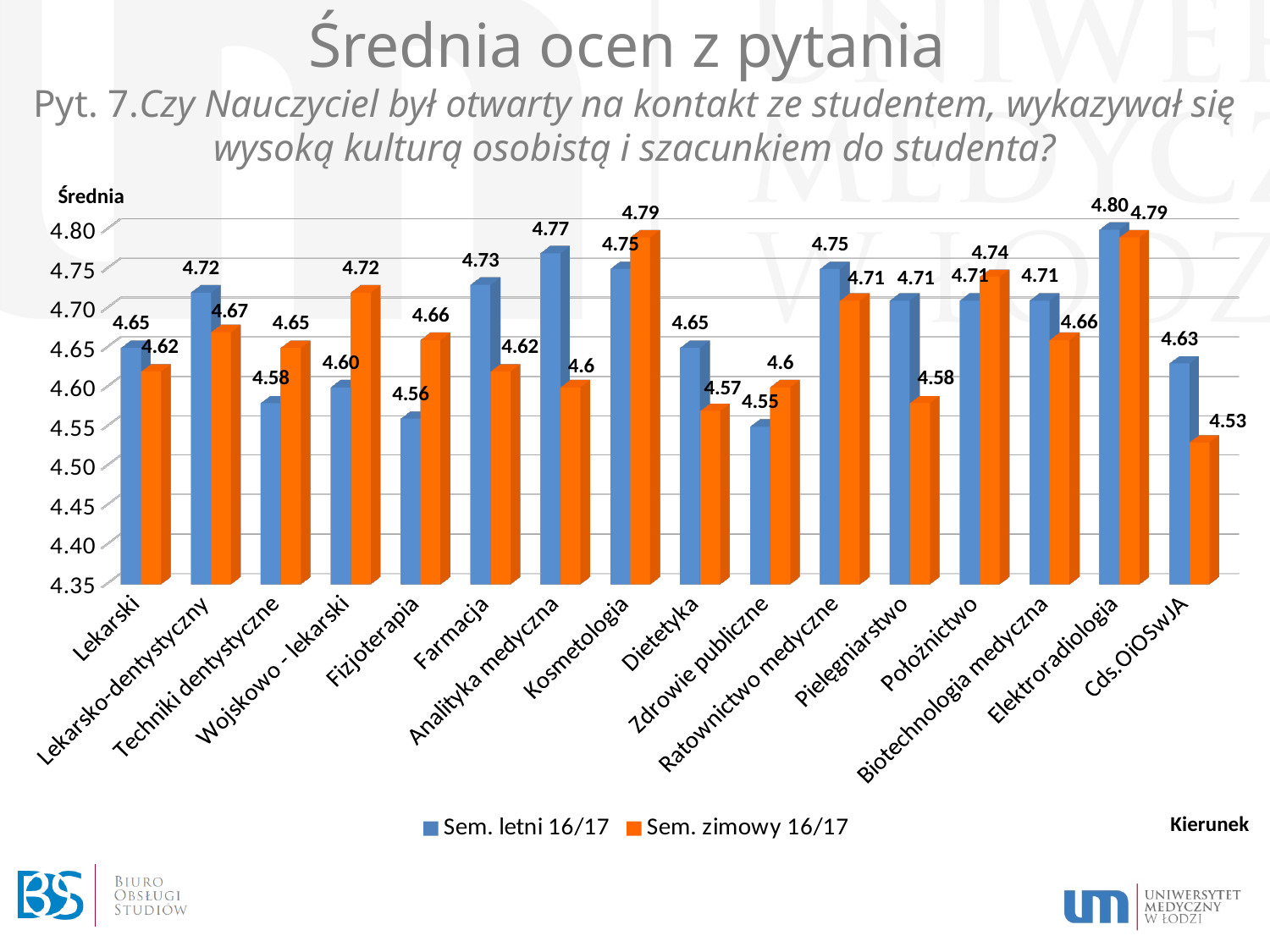
Which category has the lowest Sem. zimowy 16/17 value? Cds.OiOSwJA Is the Sem. letni 16/17 value for Fizjoterapia greater or less than 4.60? less How many categories (kierunki) are shown on the x axis? 16 What is the Sem. letni 16/17 value for Farmacja? 4.73 Which is larger for Analityka medyczna: the Sem. letni 16/17 value or the Sem. zimowy 16/17 value? Sem. letni 16/17 What is the Sem. zimowy 16/17 value for Wojskowo - lekarski? 4.72 What is the Sem. zimowy 16/17 value for Cds.OiOSwJA? 4.53 What is the difference between the Sem. letni 16/17 and Sem. zimowy 16/17 values for Pielęgniarstwo? 0.13 How many series does the legend list? 2 What kind of chart is shown on the slide? Bar chart Which category has the lowest Sem. letni 16/17 value? Zdrowie publiczne Which category has the highest Sem. letni 16/17 value? Elektroradiologia